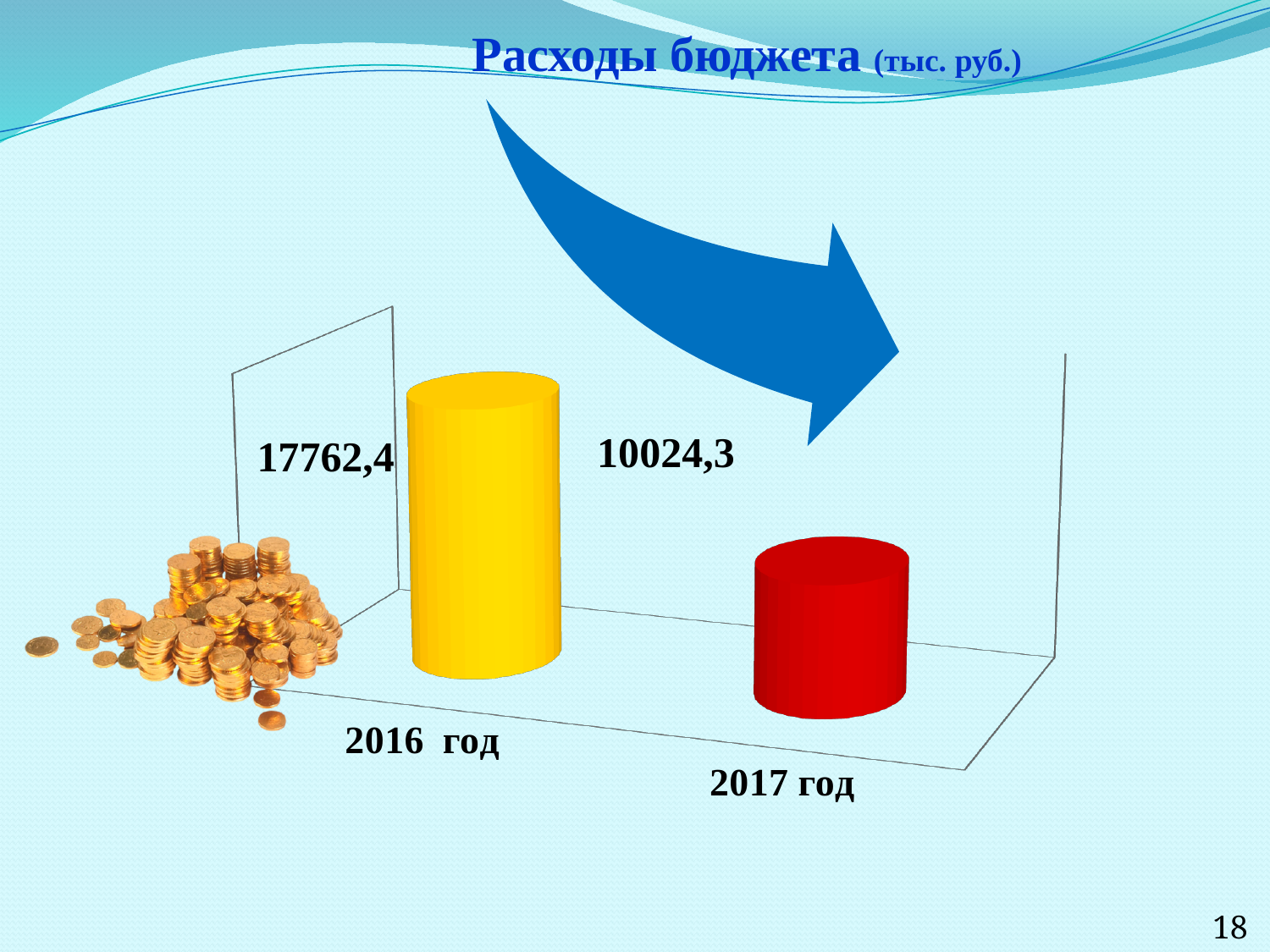
What is the title of the chart? Расходы бюджета (тыс. руб.) Which is larger, the value for 2016 год or the value for 2017 год? 2016 год What is the value for 2016 год? 17762,4 Do the values rise or fall from 2016 год to 2017 год? Fall Which year has the lowest budget expenditure? 2017 год What is the value for 2017 год? 10024,3 How many categories are shown in the chart? 2 What colour is the bar for 2017 год? Red Which year has the highest budget expenditure? 2016 год What is the difference between the values for 2016 год and 2017 год? 7738,1 What kind of chart is shown on the slide? Bar chart